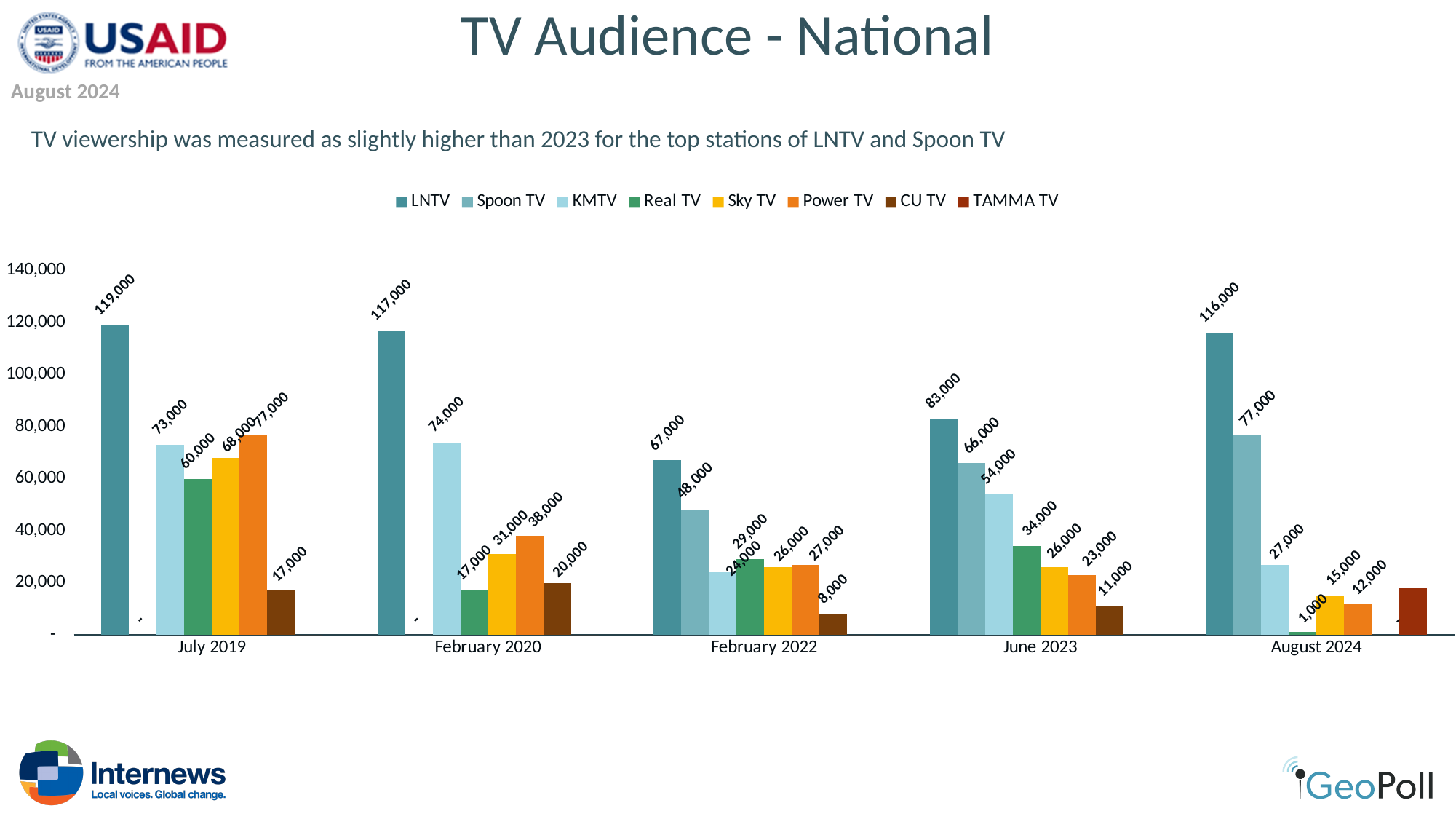
How many time periods are shown on the x axis? 5 Which is larger in July 2019, Power TV or Sky TV? Power TV Does the Spoon TV value rise or fall from February 2022 to August 2024? rise How many series does the legend list? 8 In which period is the LNTV value highest? July 2019 What kind of chart is shown on the slide? bar chart What is the value for Real TV in August 2024? 1,000 What is the difference between LNTV and Spoon TV in August 2024? 39,000 In which period is the LNTV value lowest? February 2022 What is the value for LNTV in August 2024? 116,000 What is the value for Spoon TV in June 2023? 66,000